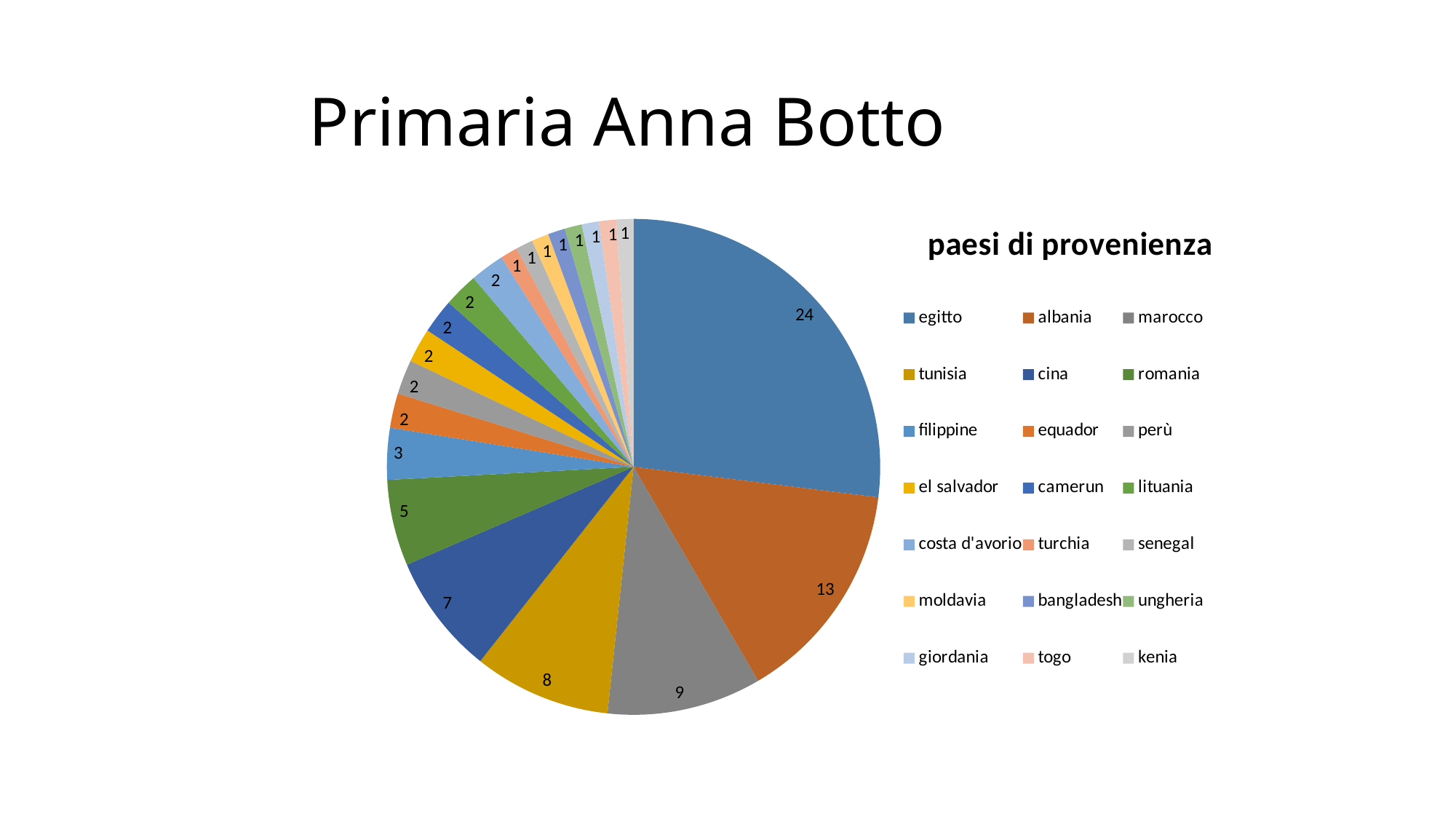
What is the difference between the values for egitto and albania? 11 What type of chart is shown on the slide? pie chart What is the value for albania in the pie chart? 13 Which is larger, the value for tunisia or the value for cina? tunisia Which is larger, the value for filippine or the value for romania? romania What is the value for romania in the pie chart? 5 What is the title of the chart? paesi di provenienza What is the difference between the values for marocco and tunisia? 1 What is the value for egitto in the pie chart? 24 How many countries are listed in the pie chart's legend? 21 Which country has the largest slice in the pie chart? egitto What is the value for cina in the pie chart? 7